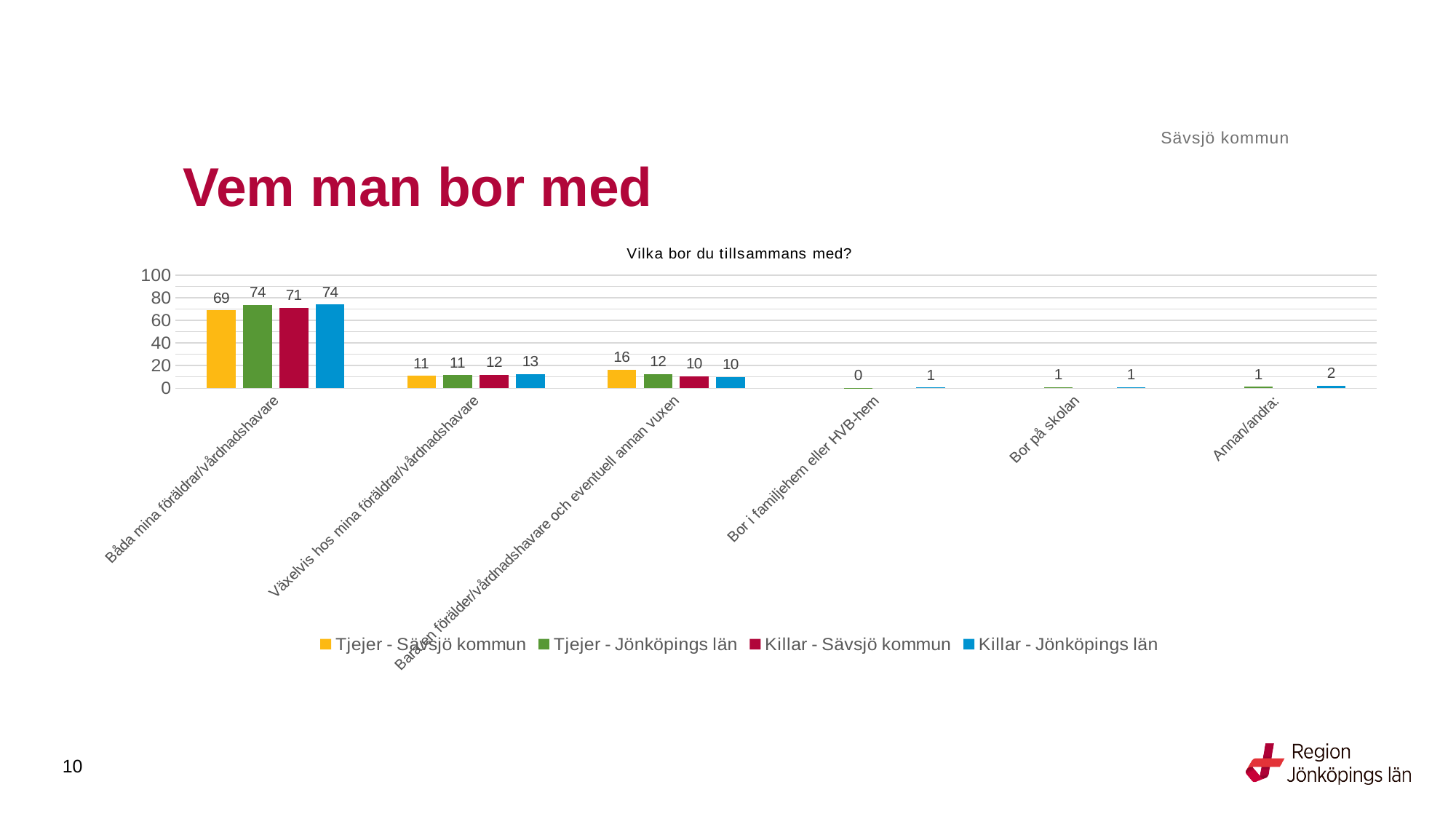
What is the title of the chart? Vilka bor du tillsammans med? In the category 'Bara en förälder/vårdnadshavare och eventuell annan vuxen', which is larger: Tjejer - Sävsjö kommun or Tjejer - Jönköpings län? Tjejer - Sävsjö kommun Which category has the highest values across all series? Båda mina föräldrar/vårdnadshavare What type of chart is shown on the slide? bar chart What is the difference between Tjejer - Jönköpings län and Tjejer - Sävsjö kommun in the category 'Båda mina föräldrar/vårdnadshavare'? 5 Is the value for Killar - Jönköpings län in 'Båda mina föräldrar/vårdnadshavare' greater or less than 60? greater What is the value for Tjejer - Sävsjö kommun in the category 'Bara en förälder/vårdnadshavare och eventuell annan vuxen'? 16 What is the value for Killar - Jönköpings län in the category 'Annan/andra'? 2 What is the value for Killar - Sävsjö kommun in the category 'Båda mina föräldrar/vårdnadshavare'? 71 What is the value for Tjejer - Sävsjö kommun in the category 'Båda mina föräldrar/vårdnadshavare'? 69 How many series does the legend list? 4 What is the value for Killar - Jönköpings län in the category 'Växelvis hos mina föräldrar/vårdnadshavare'? 13